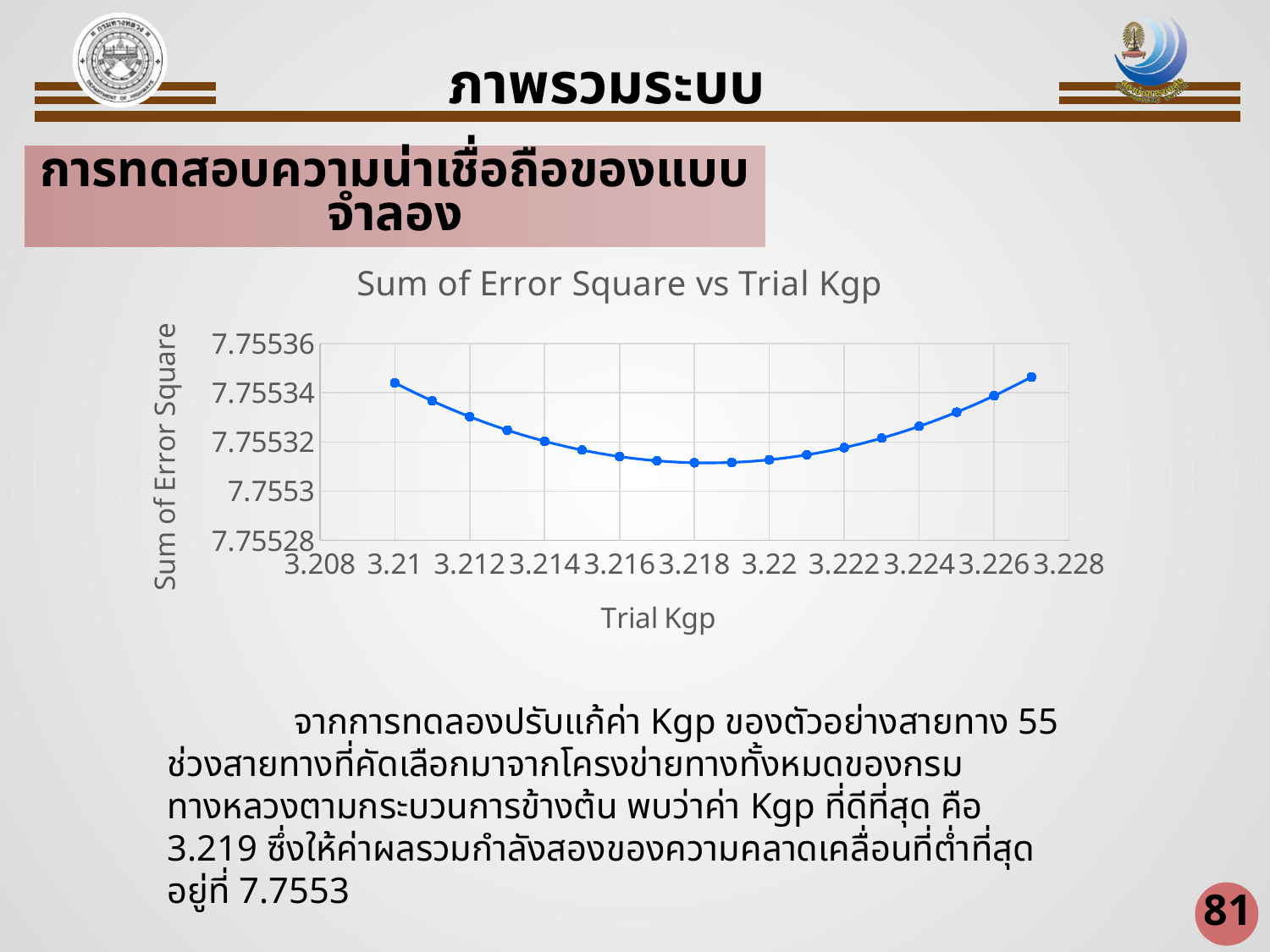
Which has a higher Sum of Error Square: Trial Kgp 3.214 or Trial Kgp 3.226? 3.226 Is the Sum of Error Square at Trial Kgp 3.227 greater or less than 7.75534? greater What is the label of the x axis of the chart? Trial Kgp Is the Sum of Error Square at Trial Kgp 3.21 greater or less than 7.75532? greater Is the Sum of Error Square at Trial Kgp 3.218 greater or less than 7.75532? less What is the title of the chart? Sum of Error Square vs Trial Kgp How does the Sum of Error Square change as Trial Kgp increases from 3.21 to 3.227? It falls, then rises What is the lowest value shown on the y axis of the chart? 7.75528 Which has a higher Sum of Error Square: Trial Kgp 3.21 or Trial Kgp 3.218? 3.21 How many data points are plotted on the chart? 18 What kind of chart is shown on the slide? Line chart